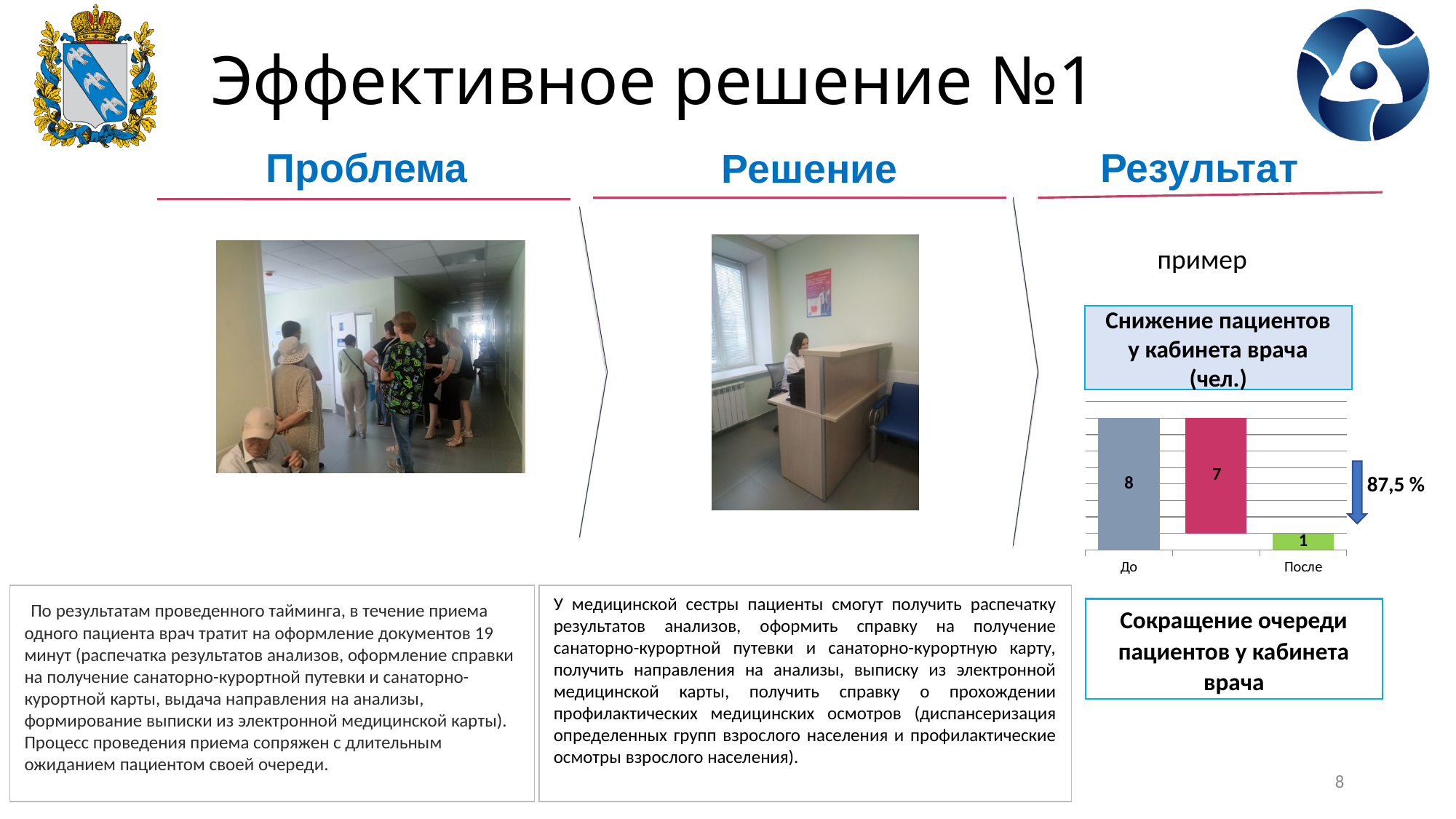
Which bar in the chart has the lowest value? После Which bar in the chart has the highest value? До What is the value of the middle (pink) bar in the chart? 7 How many bars are plotted in the chart? 3 What percentage reduction is shown next to the arrow beside the chart? 87,5 % Which is larger in the chart, the value for "До" or the value for "После"? До What is the title of the chart on the slide? Снижение пациентов у кабинета врача (чел.) What is the value of the bar labelled "До" in the chart? 8 What is the value of the bar labelled "После" in the chart? 1 What is the difference between the "До" and "После" values in the chart? 7 What kind of chart is shown under the heading "Результат"? bar chart Do the values in the chart rise or fall from left to right? fall